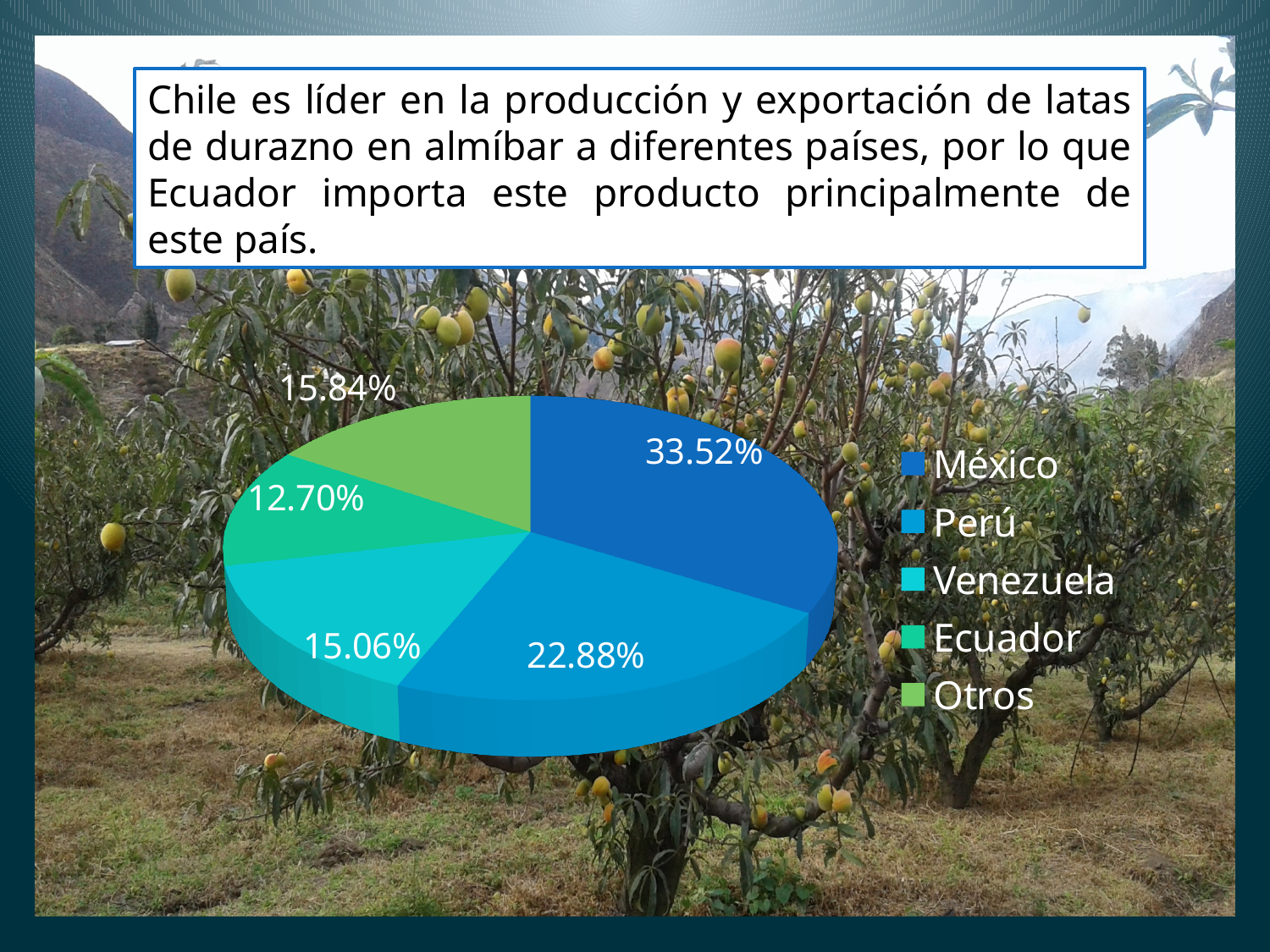
Which is larger, the slice for Otros or the slice for Venezuela? Otros What share of the pie does Venezuela have? 15.06% What share of the pie does Ecuador have? 12.70% What share of the pie does Otros have? 15.84% What kind of chart is shown on the slide? Pie chart Which category has the largest slice of the pie? México Which category is shown in green in the legend, listed fourth? Ecuador What is the difference in percentage points between México and Perú? 10.64 What share of the pie does Perú have? 22.88% Which category has the smallest slice of the pie? Ecuador What share of the pie does México have? 33.52% How many slices does the pie chart have? 5